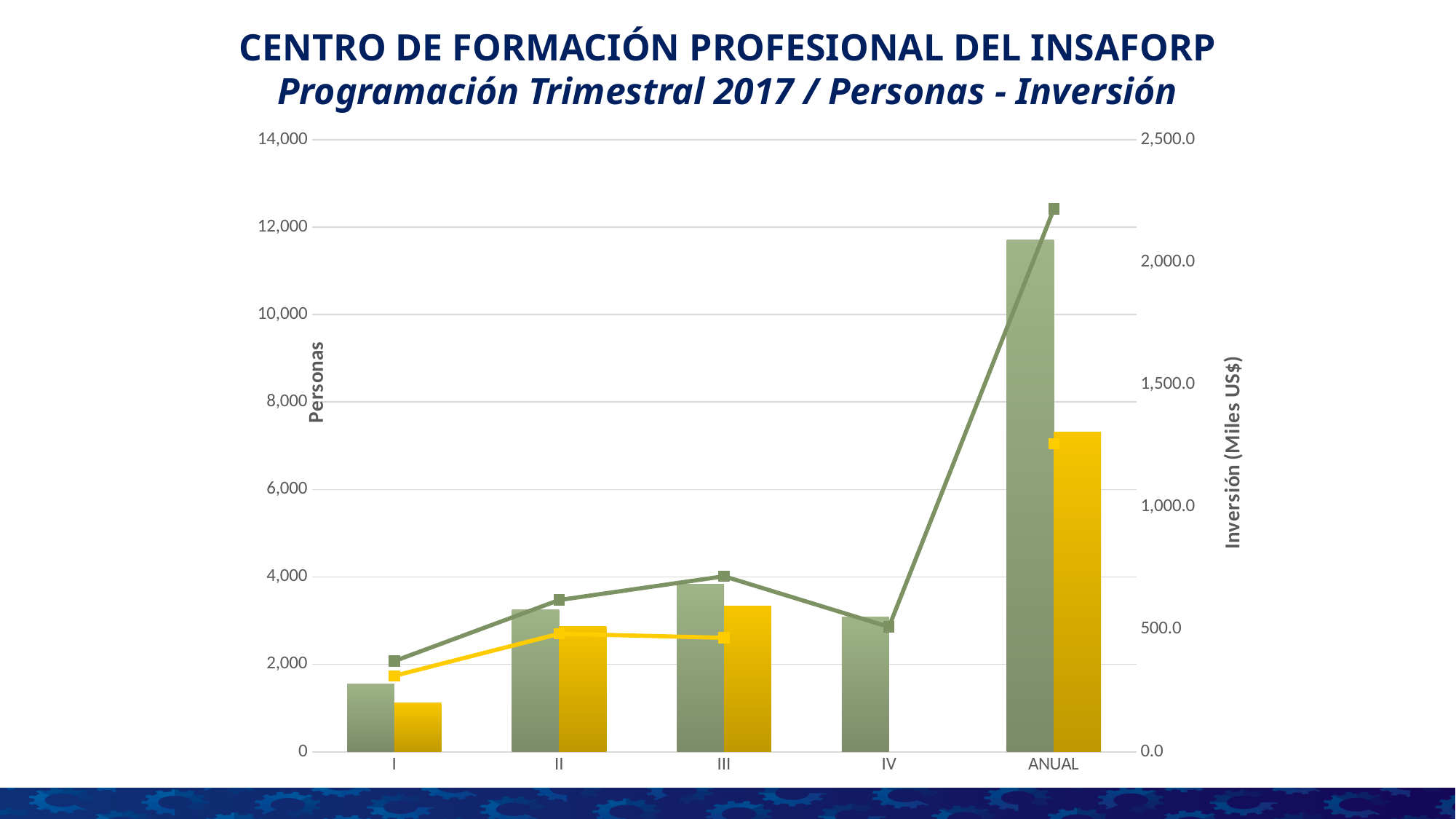
Which category has the shortest green bar? I Is the green bar for I greater or less than 2,000 on the left axis? less What is the title of the right vertical axis? Inversión (Miles US$) For ANUAL, which bar is taller, the green bar or the yellow bar? The green bar What is the title of the left vertical axis? Personas Is the yellow bar for ANUAL greater or less than 6,000 on the left axis? greater Does the green line rise or fall from category III to category IV? Falls What kind of chart is shown on the slide? Combination bar and line chart Is the green bar for ANUAL greater or less than 10,000 on the left axis? greater Which category has the tallest green bar? ANUAL How many categories are shown on the x axis? 5